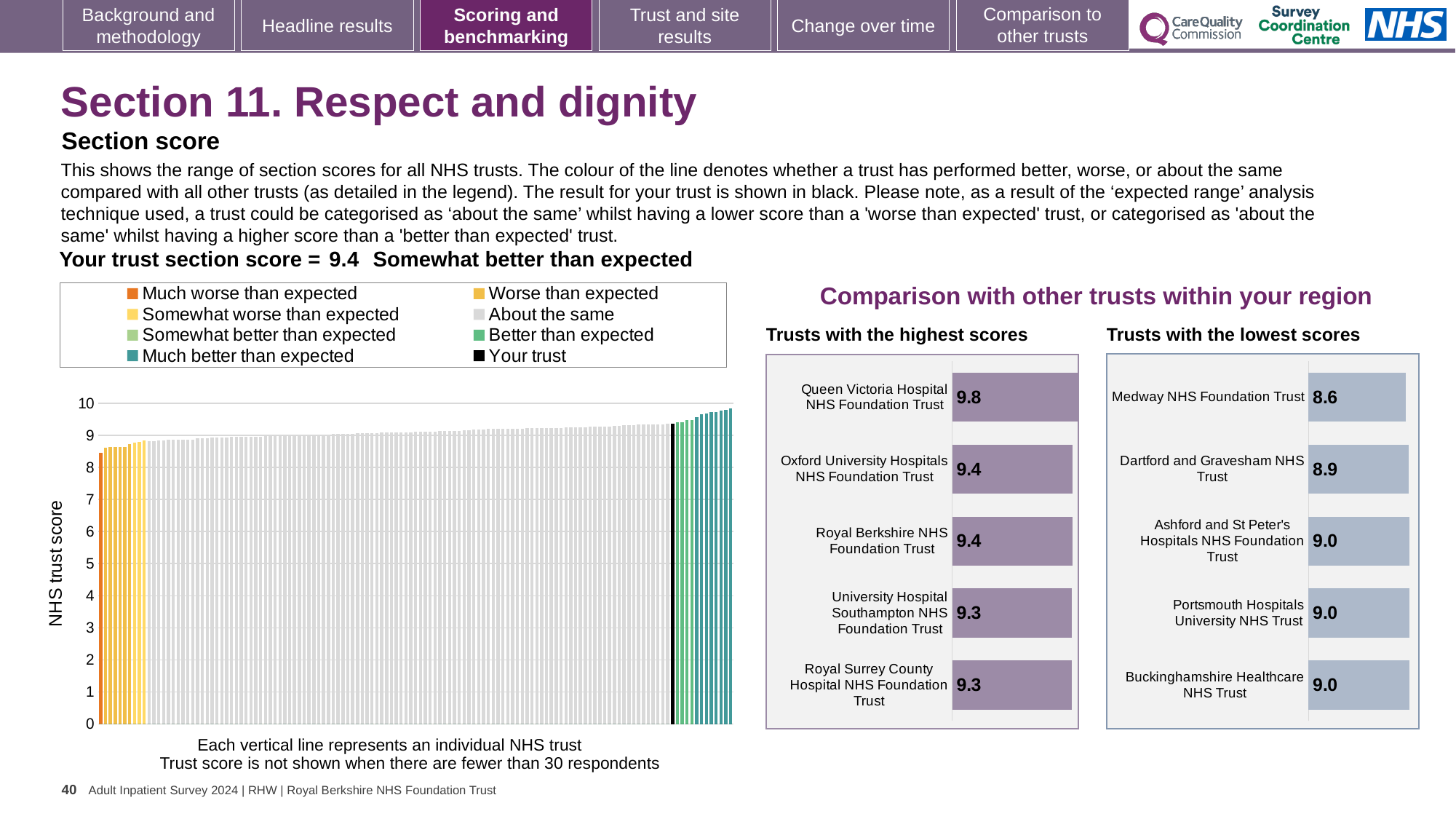
In the 'Trusts with the lowest scores' chart, what is the score for Medway NHS Foundation Trust? 8.6 In the large NHS trust score chart on the left, what colour is used for 'Your trust'? Black How many entries does the legend of the large NHS trust score chart on the left list? 8 In the 'Trusts with the highest scores' chart, which trust has the highest score? Queen Victoria Hospital NHS Foundation Trust In the large NHS trust score chart on the left, what is the section score for your trust (the black bar)? 9.4 In the 'Trusts with the highest scores' chart, what is the difference between the scores of Queen Victoria Hospital NHS Foundation Trust and Royal Berkshire NHS Foundation Trust? 0.4 In the 'Trusts with the lowest scores' chart, which trust has the lowest score? Medway NHS Foundation Trust In the 'Trusts with the highest scores' chart, what is the score for Queen Victoria Hospital NHS Foundation Trust? 9.8 What kind of chart is the 'Trusts with the highest scores' chart? Bar chart How many trusts are shown in the 'Trusts with the lowest scores' chart? 5 In the 'Trusts with the lowest scores' chart, what is the difference between the scores of Dartford and Gravesham NHS Trust and Medway NHS Foundation Trust? 0.3 In the 'Trusts with the highest scores' chart, which has the higher score: Oxford University Hospitals NHS Foundation Trust or University Hospital Southampton NHS Foundation Trust? Oxford University Hospitals NHS Foundation Trust